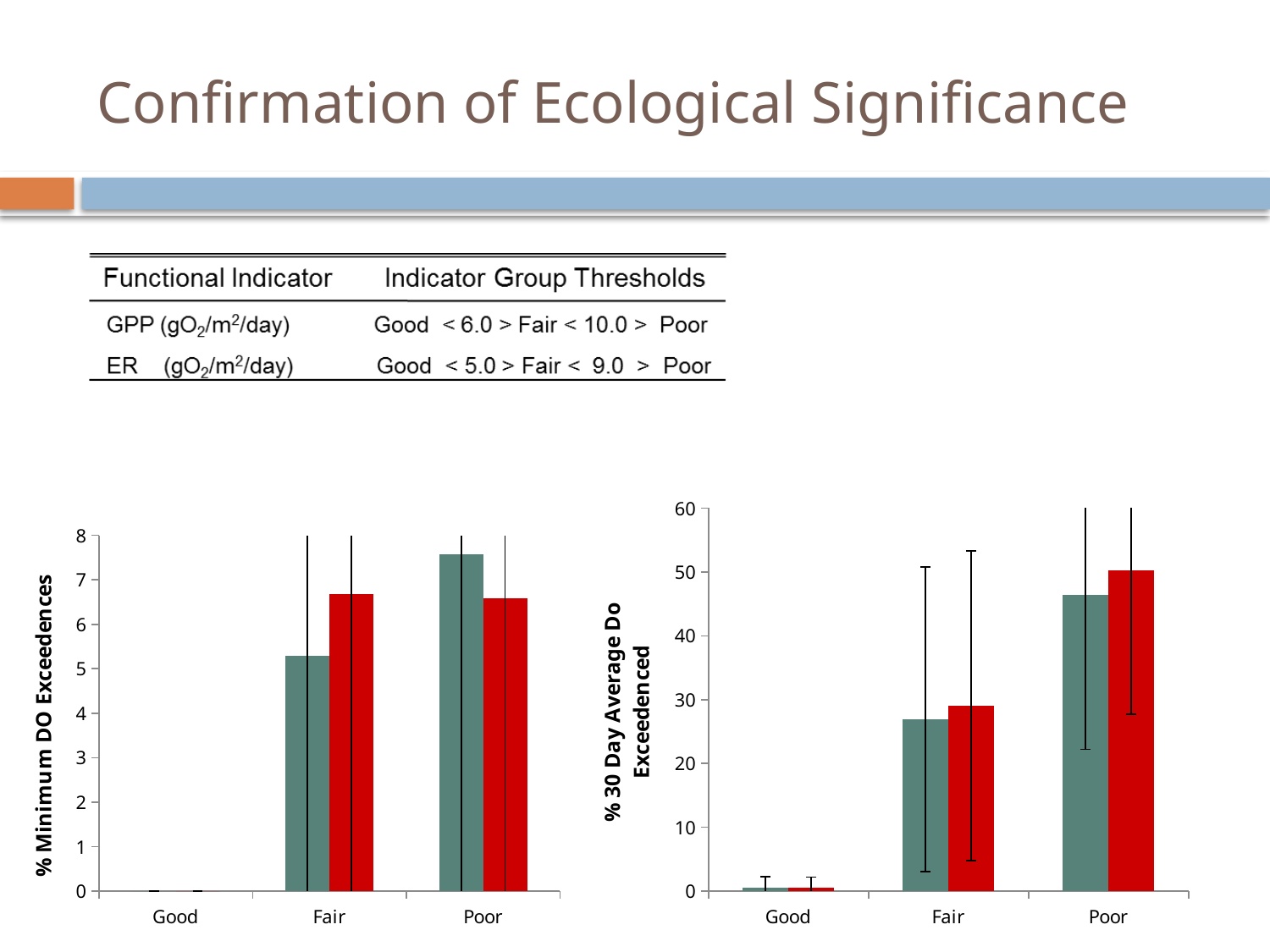
In the left chart (% Minimum DO Exceedences), is the grey-green bar for Fair greater or less than 6? less In the right chart (% 30 Day Average Do Exceedenced), is the red bar for Fair greater or less than 20? greater In the right chart (% 30 Day Average Do Exceedenced), is the red bar for Good greater or less than 10? less What kind of chart is the left chart (% Minimum DO Exceedences)? bar chart In the right chart (% 30 Day Average Do Exceedenced), do the values rise or fall from Good to Poor? rise How many categories are shown on the x axis of the left chart (% Minimum DO Exceedences)? 3 In the left chart (% Minimum DO Exceedences), which category has the lowest values? Good In the left chart (% Minimum DO Exceedences), which is larger for Fair: the grey-green bar or the red bar? the red bar In the right chart (% 30 Day Average Do Exceedenced), which category has the highest values? Poor